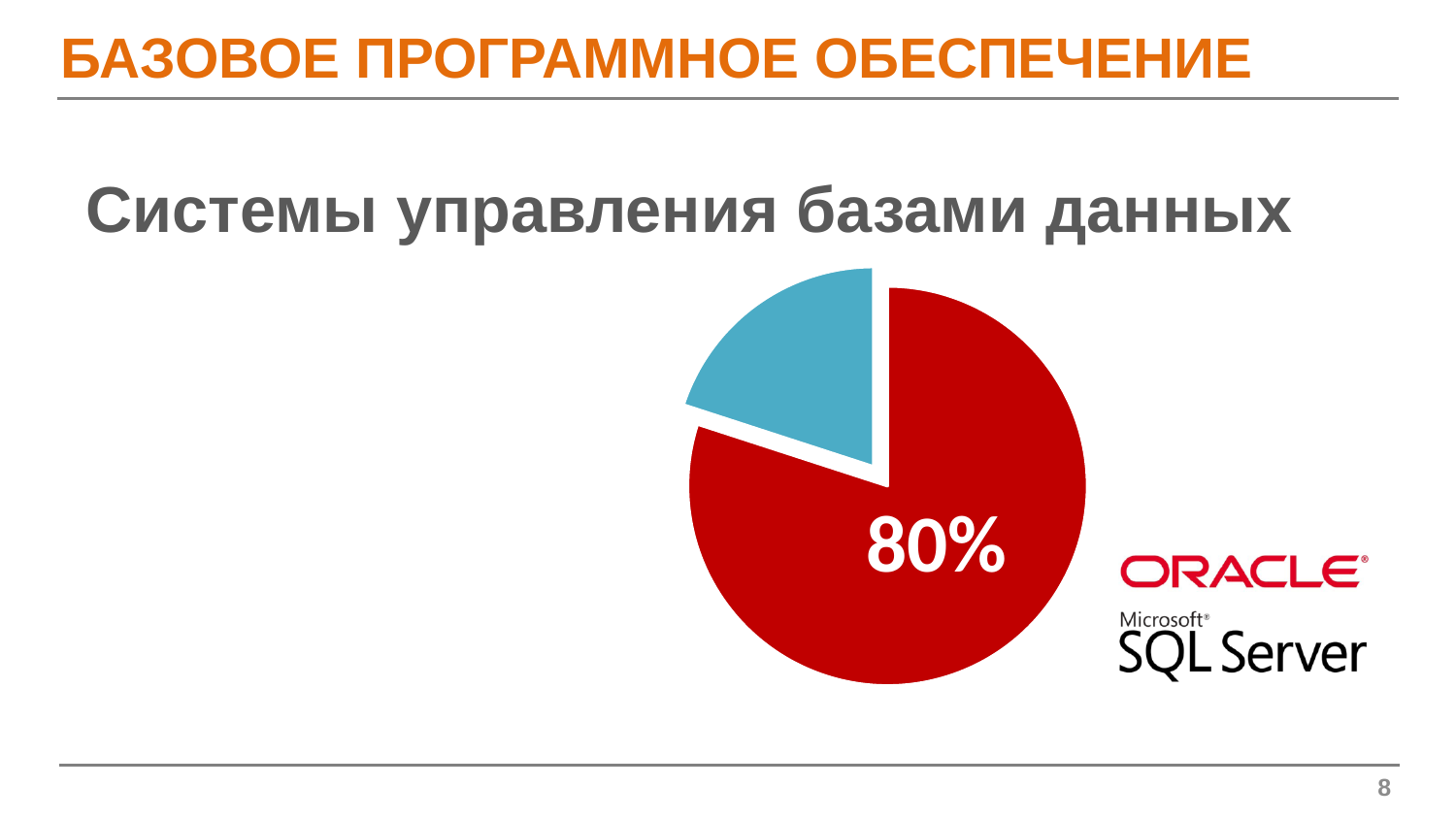
Which slice is larger, the red slice or the blue slice? the red slice Is the blue slice's share of the pie greater or less than 50%? less Which slice of the pie chart is the smallest? the blue slice Which slice of the pie chart is the largest? the red slice What share of the pie does the red slice represent? 80% What share of the pie does the blue slice represent? 20% What percentage is printed on the red slice of the pie chart? 80% What heading appears above the pie chart? Системы управления базами данных Which two product logos are shown next to the pie chart? Oracle and Microsoft SQL Server Is the red slice's share of the pie greater or less than 50%? greater How many slices does the pie chart have? 2 What kind of chart is shown on the slide? pie chart